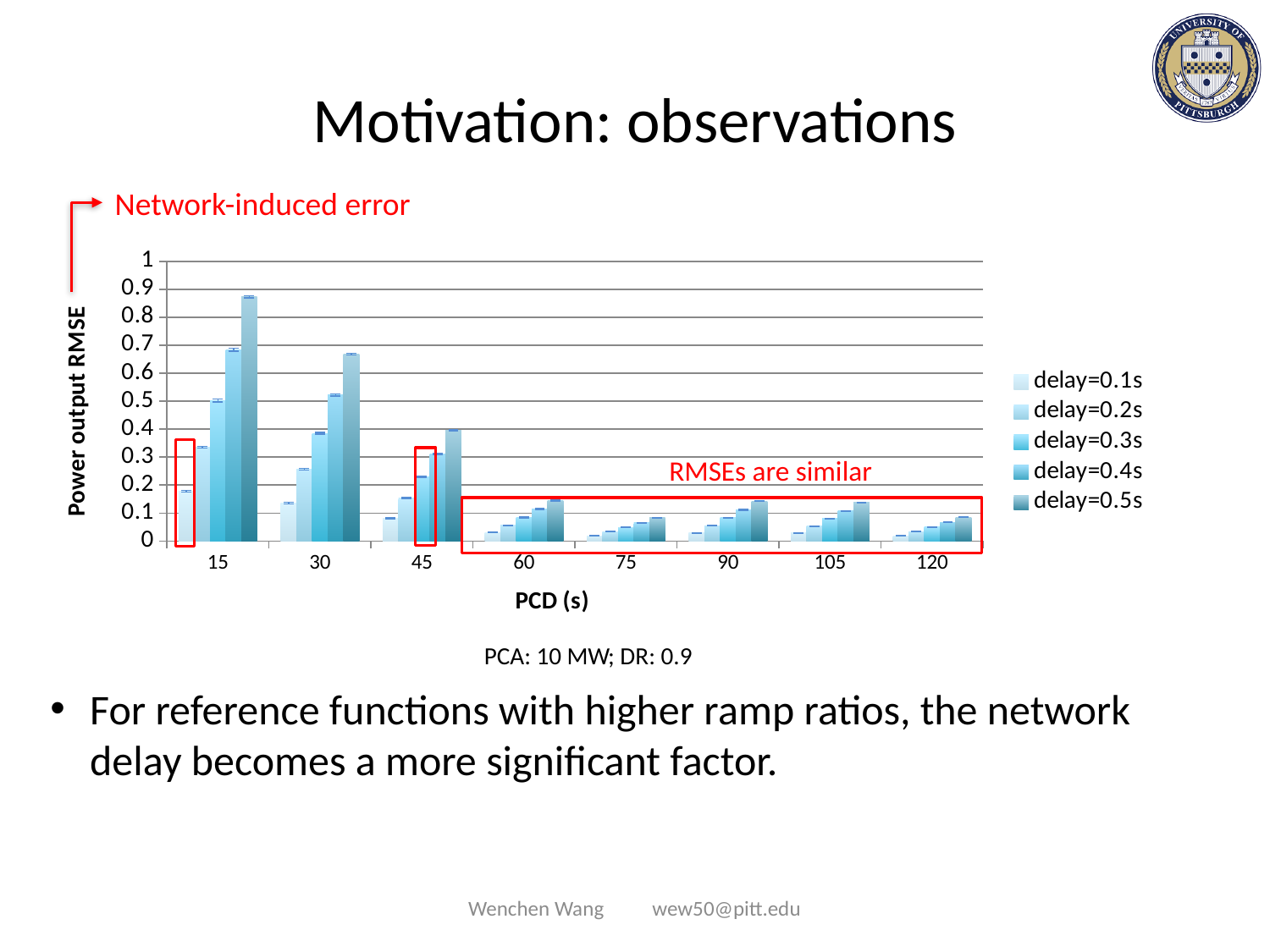
Which delay series has the lowest bar at PCD 15? delay=0.1s What is the title of the y axis? Power output RMSE Is the value for delay=0.1s at PCD 15 greater or less than 0.3? less How many PCD categories are shown on the x axis? 8 Is the value for delay=0.5s at PCD 30 greater or less than 0.6? greater How many series does the legend list? 5 What kind of chart is shown on the slide? bar chart Is the value for delay=0.5s at PCD 15 greater or less than 0.8? greater Which delay series has the highest bar at PCD 15? delay=0.5s For delay=0.5s, which is larger: the value at PCD 15 or at PCD 30? PCD 15 For delay=0.5s, do the values generally rise or fall as PCD increases from 15 to 120? fall